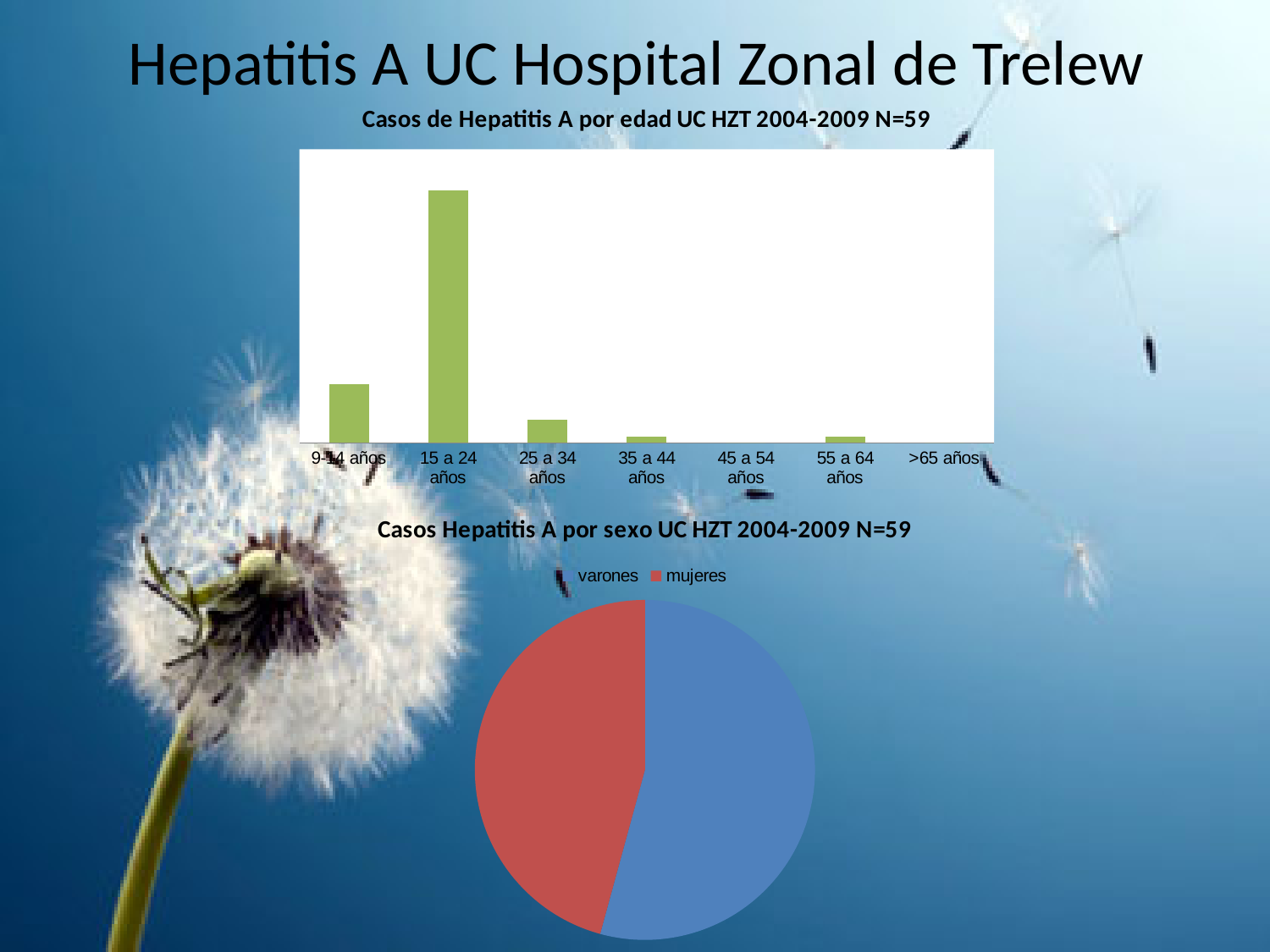
In the top bar chart (Casos de Hepatitis A por edad), how many age categories are shown on the x axis? 7 What is the title of the top bar chart on the slide? Casos de Hepatitis A por edad UC HZT 2004-2009 N=59 What kind of chart is the top chart titled "Casos de Hepatitis A por edad UC HZT 2004-2009 N=59"? Bar chart In the top bar chart (Casos de Hepatitis A por edad), which has more cases: 25 a 34 años or 35 a 44 años? 25 a 34 años In the bottom pie chart (Casos Hepatitis A por sexo), which slice is larger: varones or mujeres? varones In the bottom pie chart (Casos Hepatitis A por sexo), how many categories does the legend list? 2 In the top bar chart (Casos de Hepatitis A por edad), which has more cases: 15 a 24 años or 9-14 años? 15 a 24 años What kind of chart is the bottom chart titled "Casos Hepatitis A por sexo UC HZT 2004-2009 N=59"? Pie chart In the top bar chart (Casos de Hepatitis A por edad), which age group has the highest number of cases? 15 a 24 años In the bottom pie chart (Casos Hepatitis A por sexo), what colour is the slice for mujeres? Red